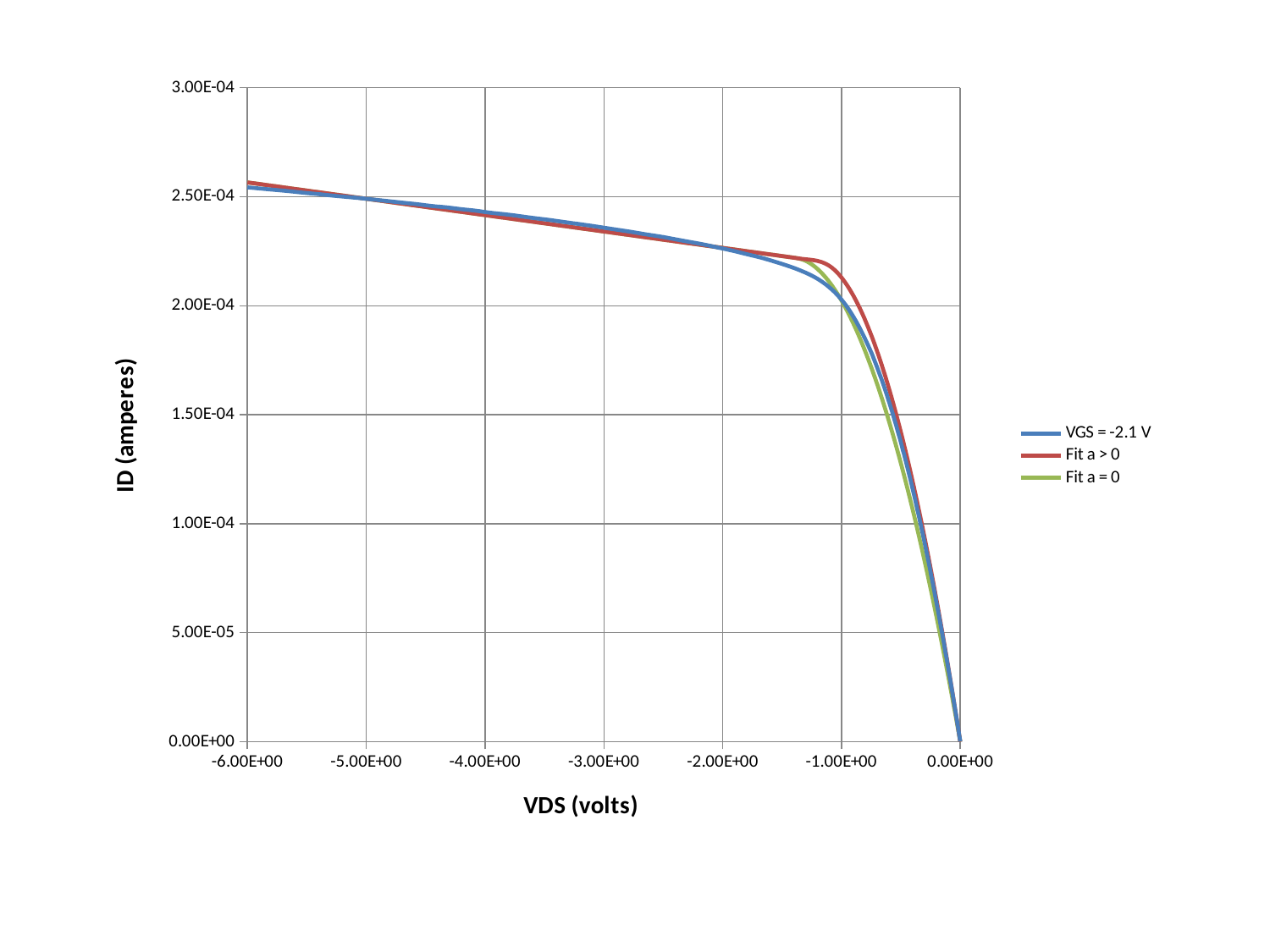
At VDS = -1.00E+00, which series has the larger ID value, Fit a > 0 or Fit a = 0? Fit a > 0 Is the value of the Fit a > 0 series at VDS = -1.00E+00 greater or less than 2.00E-04? greater What kind of chart is shown on the slide? line chart Is the value of the VGS = -2.1 V series at VDS = -3.00E+00 greater or less than 2.00E-04? greater Is the value of the VGS = -2.1 V series at VDS = -6.00E+00 greater or less than 2.50E-04? greater What is the ID value of all three series at VDS = 0.00E+00? 0.00E+00 What is the title of the y axis? ID (amperes) How many series does the legend list? 3 What is the title of the x axis? VDS (volts) Do the ID values rise or fall as VDS increases from -6.00E+00 to 0.00E+00? fall